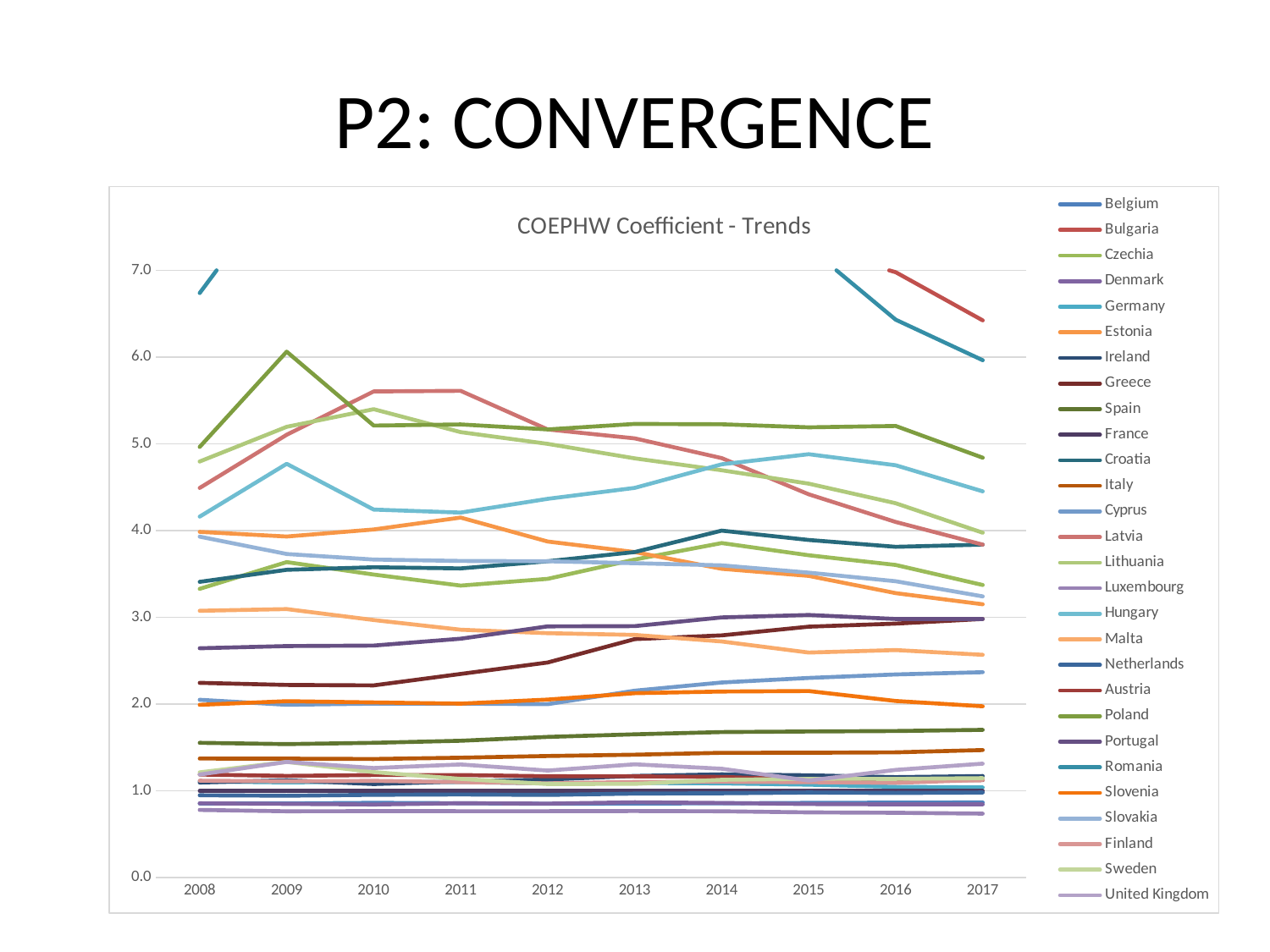
What is the title of the chart? COEPHW Coefficient - Trends What is the first year shown on the x axis? 2008 What kind of chart is shown on the slide? line chart Is the value for Bulgaria in 2017 greater or less than 6.0? greater How many series does the legend list? 28 How many years are shown along the x axis? 10 What is the highest value shown on the y axis? 7.0